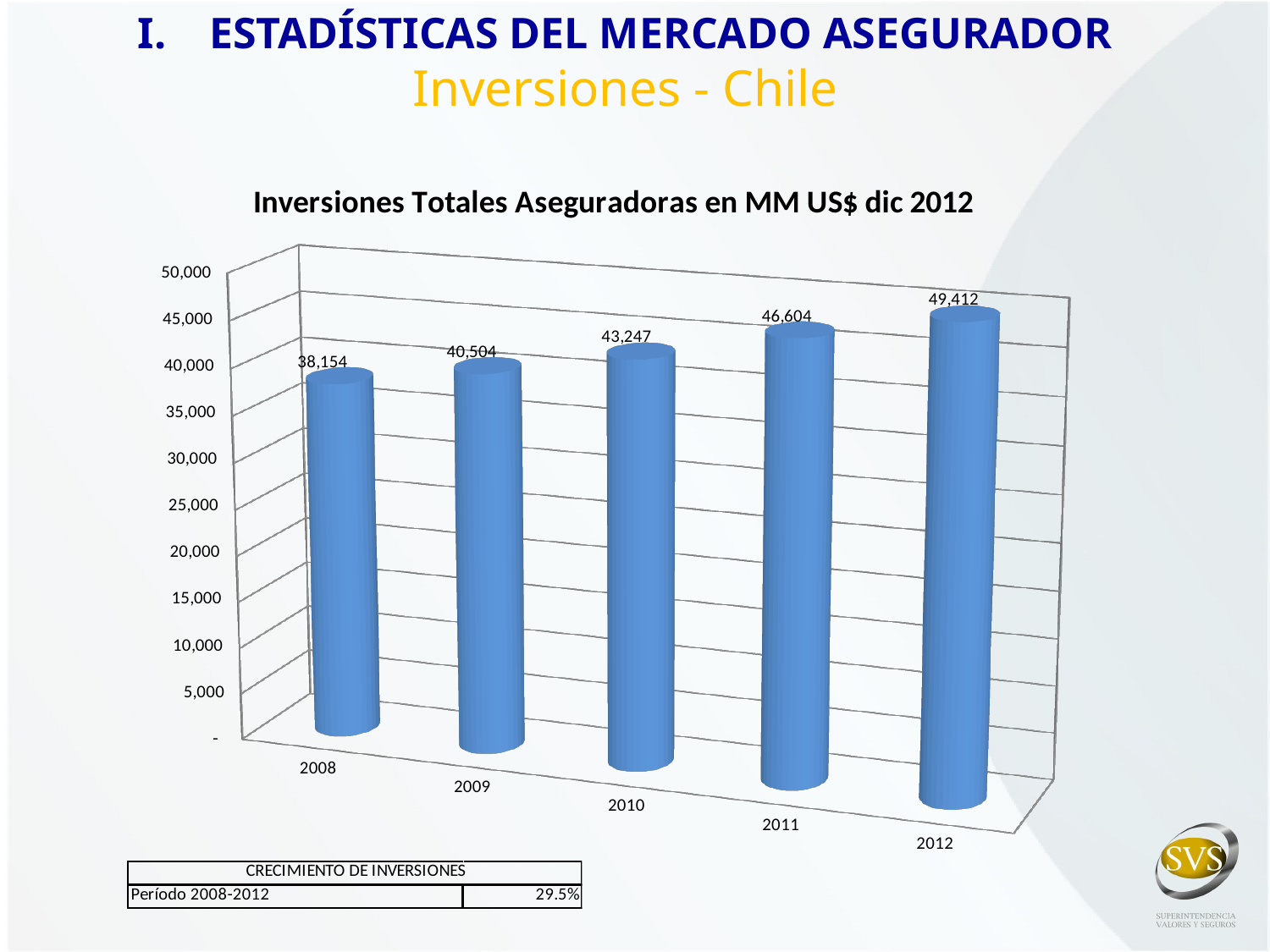
What kind of chart is this? Bar chart What is the value for 2010? 43,247 What is the difference between the values for 2012 and 2008? 11,258 How many years are shown on the chart? 5 Which is larger, the value for 2009 or the value for 2011? 2011 Which year has the highest value? 2012 What is the value for 2012? 49,412 What is the difference between the values for 2011 and 2010? 3,357 Do the values rise or fall from 2008 to 2012? Rise What is the value for 2008? 38,154 What is the title of the chart? Inversiones Totales Aseguradoras en MM US$ dic 2012 Which year has the lowest value? 2008